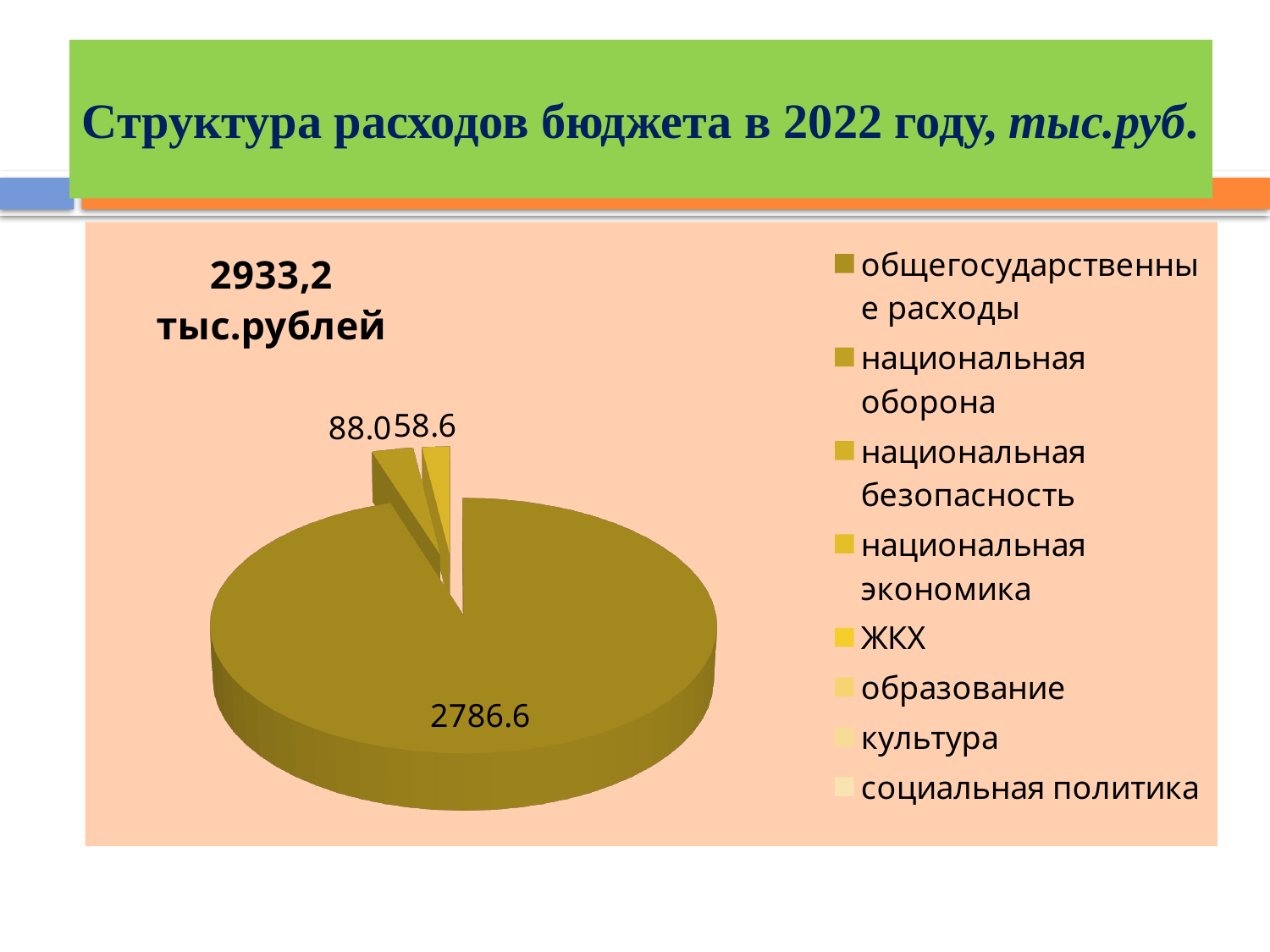
What total amount is printed above the pie chart? 2933,2 тыс.рублей What is the last category listed in the legend of the pie chart? социальная политика How many categories does the legend of the pie chart list? 8 What is the difference between the largest slice (2786.6) and the slice labelled 88.0? 2698.6 What is the title of the chart on the slide? 2933,2 тыс.рублей What is the value shown for общегосударственные расходы in the pie chart? 2786.6 Which category has the largest slice in the pie chart? общегосударственные расходы What is the smallest value labelled on the pie chart? 58.6 What is the difference between the two small slices labelled 88.0 and 58.6? 29.4 What kind of chart is shown on the slide? pie chart Which is larger, the slice labelled 88.0 or the slice labelled 58.6? 88.0 What is the value of the largest slice of the pie chart? 2786.6